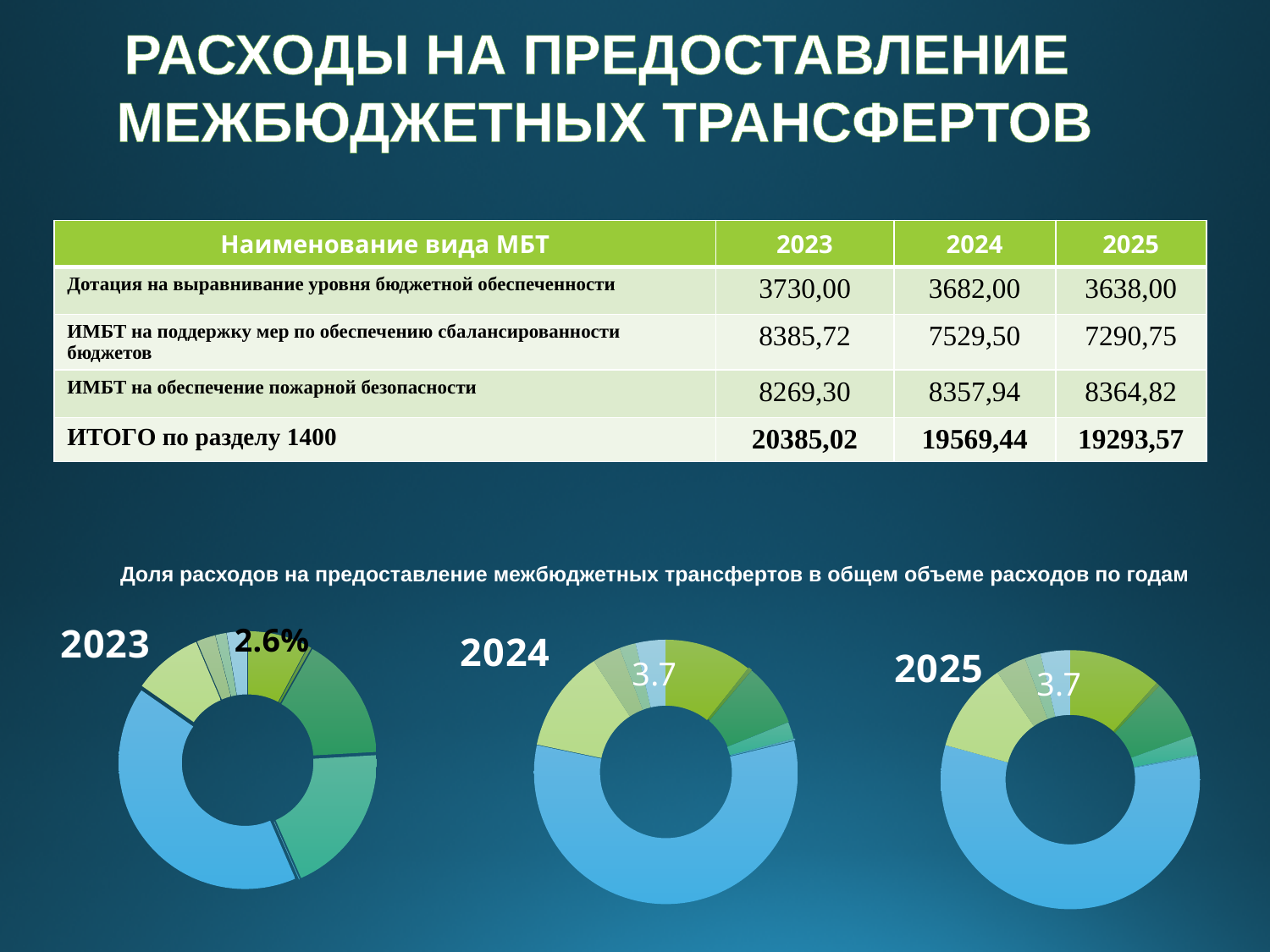
How many pie charts are shown on the slide? 3 Do the labeled shares in the pie charts rise or fall from 2023 to 2024? rise In the 2025 pie chart, what value is printed on the labeled slice? 3.7 What is the title printed above the three pie charts? Доля расходов на предоставление межбюджетных трансфертов в общем объеме расходов по годам Which labeled share is larger: the one in the 2023 pie chart or the one in the 2024 pie chart? 2024 Which years are the three pie charts labeled with? 2023, 2024, 2025 In the 2023 pie chart, what value is printed on the labeled slice? 2.6% What kind of chart is used to show the share of expenditures for 2023? pie chart (donut) In the 2024 pie chart, what value is printed on the labeled slice? 3.7